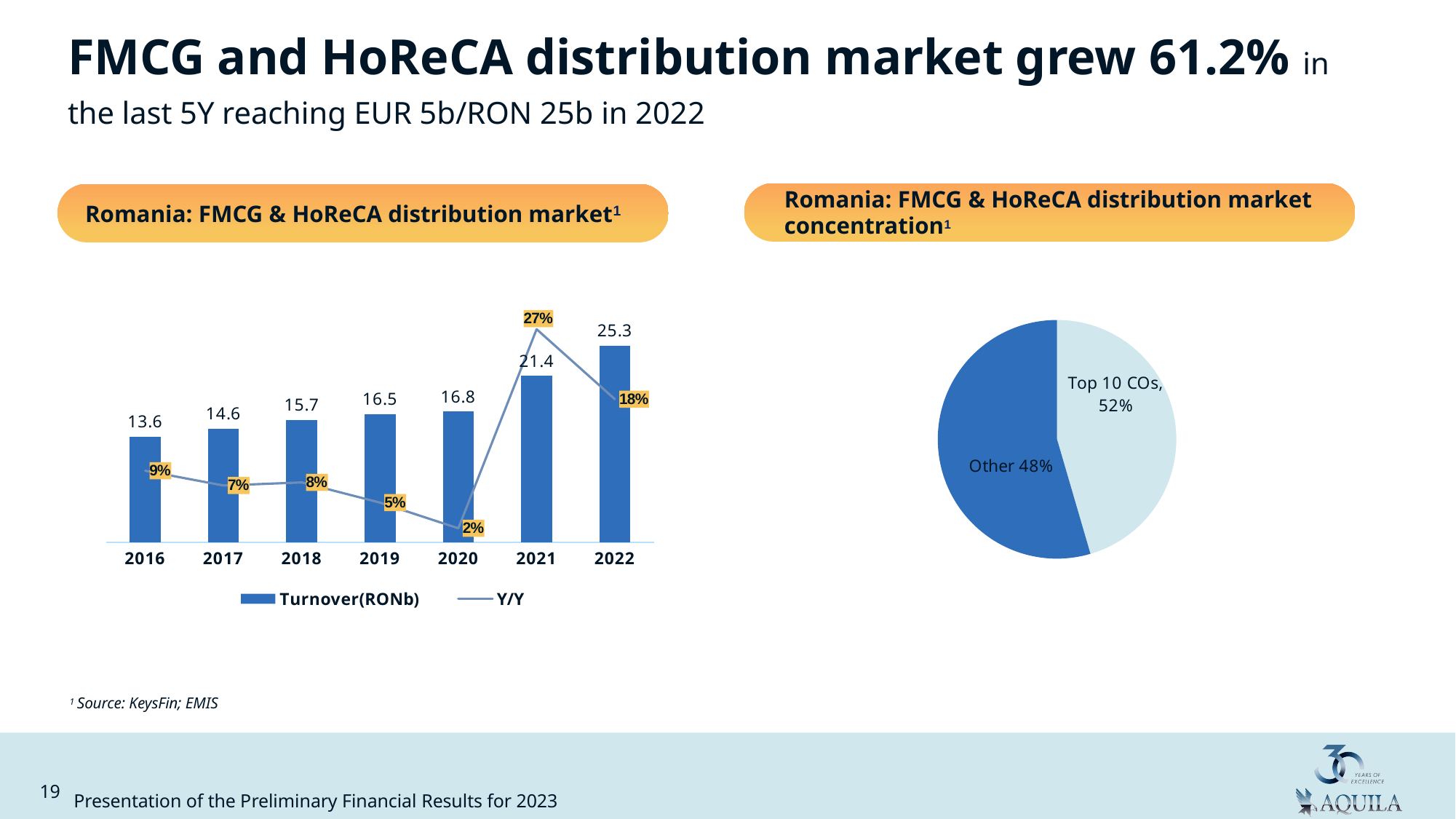
What kind of chart is the right chart (Romania: FMCG & HoReCA distribution market concentration)? pie chart In the left chart (Romania: FMCG & HoReCA distribution market), what are the two legend entries? Turnover(RONb) and Y/Y In the left chart (Romania: FMCG & HoReCA distribution market), which year had higher turnover, 2019 or 2020? 2020 In the right chart (Romania: FMCG & HoReCA distribution market concentration), what share of the market do the Top 10 COs hold? 52% In the left chart (Romania: FMCG & HoReCA distribution market), what is the difference in turnover between 2022 and 2016? 11.7 In the left chart (Romania: FMCG & HoReCA distribution market), what was the Y/Y growth in 2021? 27% In the left chart (Romania: FMCG & HoReCA distribution market), which year had the lowest Y/Y growth? 2020 In the left chart (Romania: FMCG & HoReCA distribution market), what was the turnover in RONb in 2022? 25.3 In the left chart (Romania: FMCG & HoReCA distribution market), how many years are shown on the x axis? 7 In the left chart (Romania: FMCG & HoReCA distribution market), which year had the highest turnover? 2022 In the left chart (Romania: FMCG & HoReCA distribution market), how many series does the legend list? 2 In the left chart (Romania: FMCG & HoReCA distribution market), does turnover rise or fall from 2016 to 2022? rise